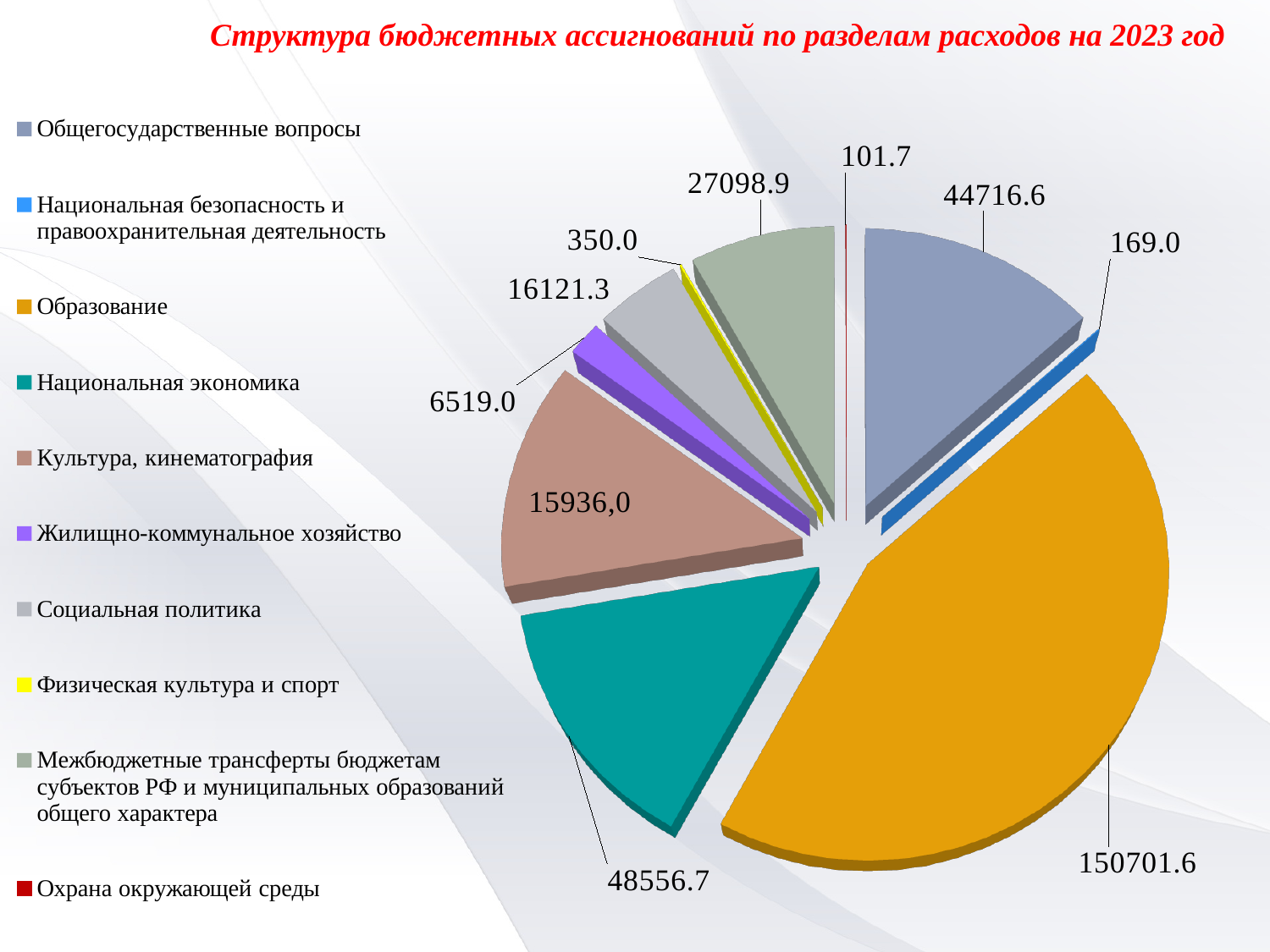
What is the value for Межбюджетные трансферты бюджетам субъектов РФ и муниципальных образований общего характера? 27098.9 What is the value for Образование? 150701.6 What is the value for Охрана окружающей среды? 101.7 What is the title of the chart? Структура бюджетных ассигнований по разделам расходов на 2023 год Which category has the smallest value? Охрана окружающей среды Which category has the largest slice of the pie? Образование What is the value for Общегосударственные вопросы? 44716.6 Which is larger, the value for Социальная политика or the value for Жилищно-коммунальное хозяйство? Социальная политика What is the difference between the values for Образование and Национальная экономика? 102144.9 How many categories does the legend list? 10 What kind of chart is shown on the slide? pie chart What is the value for Национальная экономика? 48556.7